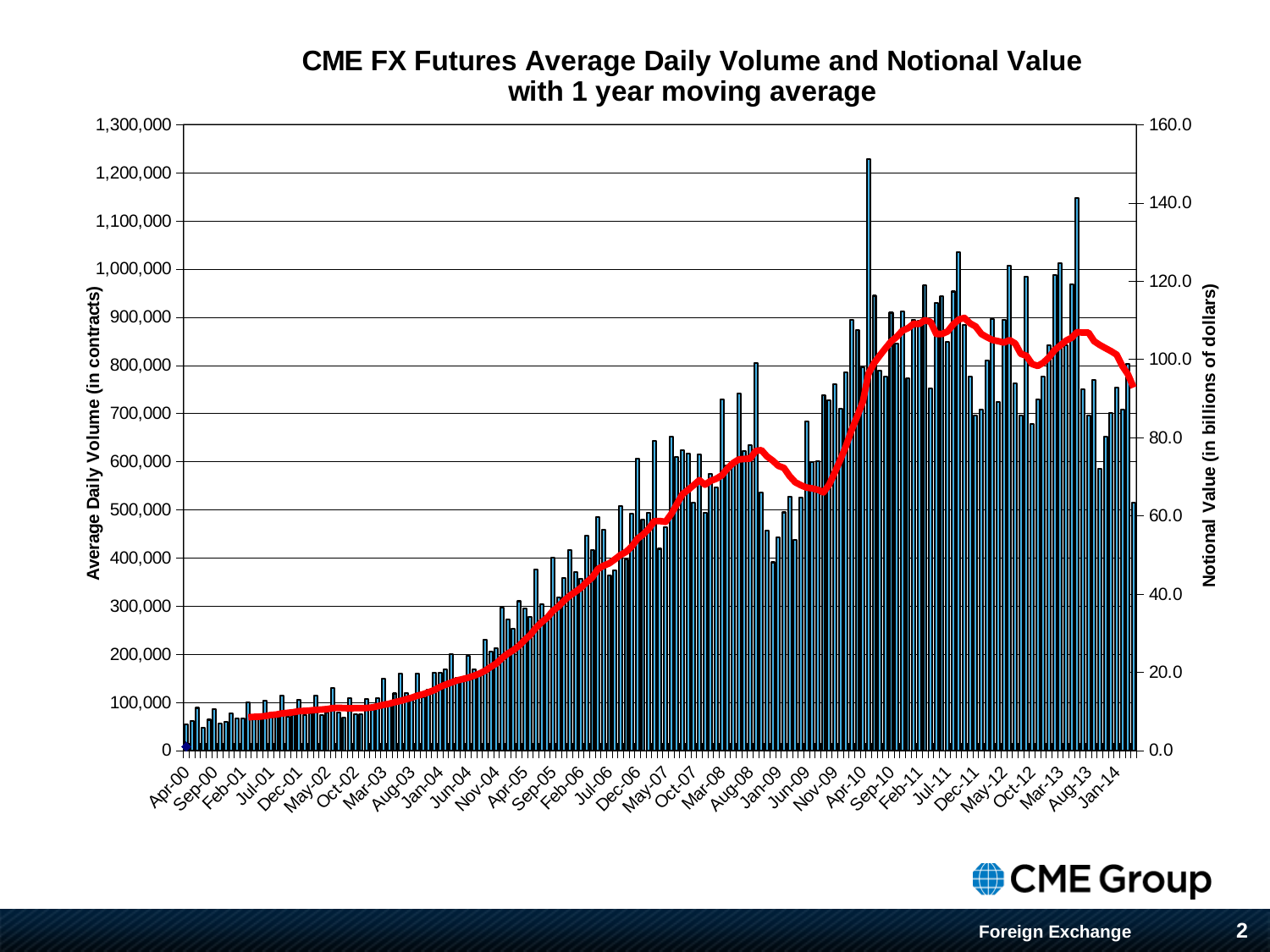
Which has the larger average daily volume bar, Apr-00 or Jan-14? Jan-14 Is the tallest average daily volume bar greater or less than 1,200,000? greater Is the average daily volume bar at Jan-04 greater or less than 500,000? less Is the red moving-average line at Dec-11 greater or less than 80.0 on the right axis? greater What is the title of the chart? CME FX Futures Average Daily Volume and Notional Value with 1 year moving average Which is higher on the red moving-average line, Feb-01 or Jul-11? Jul-11 What kind of chart is shown on the slide? A combined bar and line chart What is the title of the left vertical axis? Average Daily Volume (in contracts) Overall, do the average daily volume bars rise or fall from Apr-00 to Jan-14? Rise